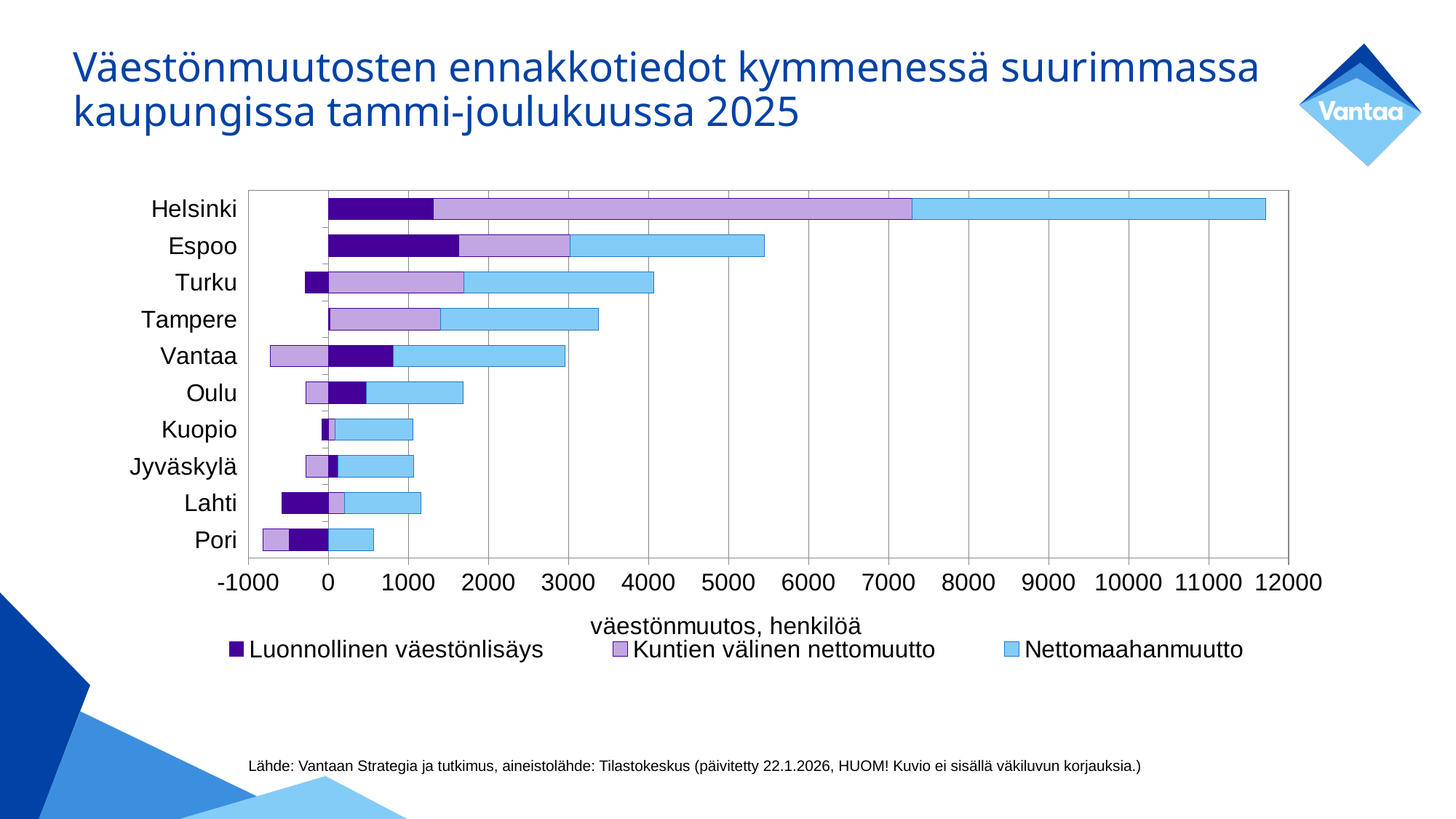
How many cities are shown on the chart? 10 Is the end of the Espoo bar greater or less than 5000? greater Is the end of the Tampere bar greater or less than 3000? greater How many series does the legend list? 3 Is the end of the Pori bar greater or less than 1000? less Which city has the larger Nettomaahanmuutto segment, Helsinki or Espoo? Helsinki What kind of chart is shown on the slide? Stacked horizontal bar chart Which city has the smallest Nettomaahanmuutto segment? Pori Which city has the larger Kuntien välinen nettomuutto segment, Helsinki or Espoo? Helsinki What is the label of the horizontal axis? väestönmuutos, henkilöä Which city has the longest total bar on the chart? Helsinki